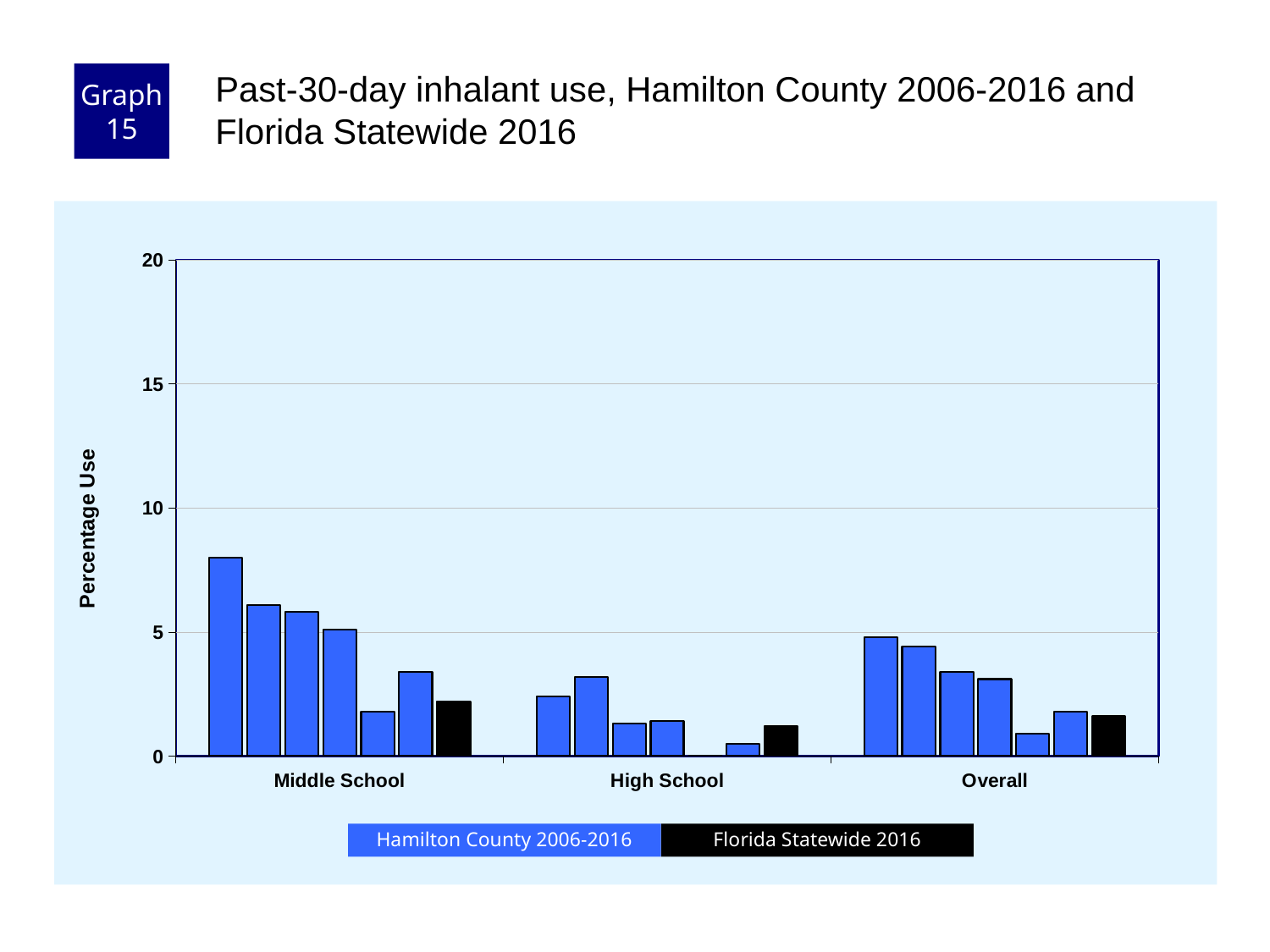
Is the value of the tallest Hamilton County bar in the High School group greater or less than 5? less Which category group has the lowest Florida Statewide 2016 bar? High School Which is larger, the Florida Statewide 2016 bar for Middle School or the Florida Statewide 2016 bar for High School? Middle School How many category groups are shown on the x axis? 3 What kind of chart is shown on the slide? bar chart Do the Hamilton County 2006-2016 bars in the Overall group generally rise or fall from left to right? fall Which category group contains the tallest bar on the chart? Middle School What is the label of the y axis? Percentage Use Is the value of the Florida Statewide 2016 bar for High School greater or less than 5? less How many series does the legend list? 2 Is the value of the tallest Hamilton County bar in the Middle School group greater or less than 5? greater What colour are the Florida Statewide 2016 bars? black